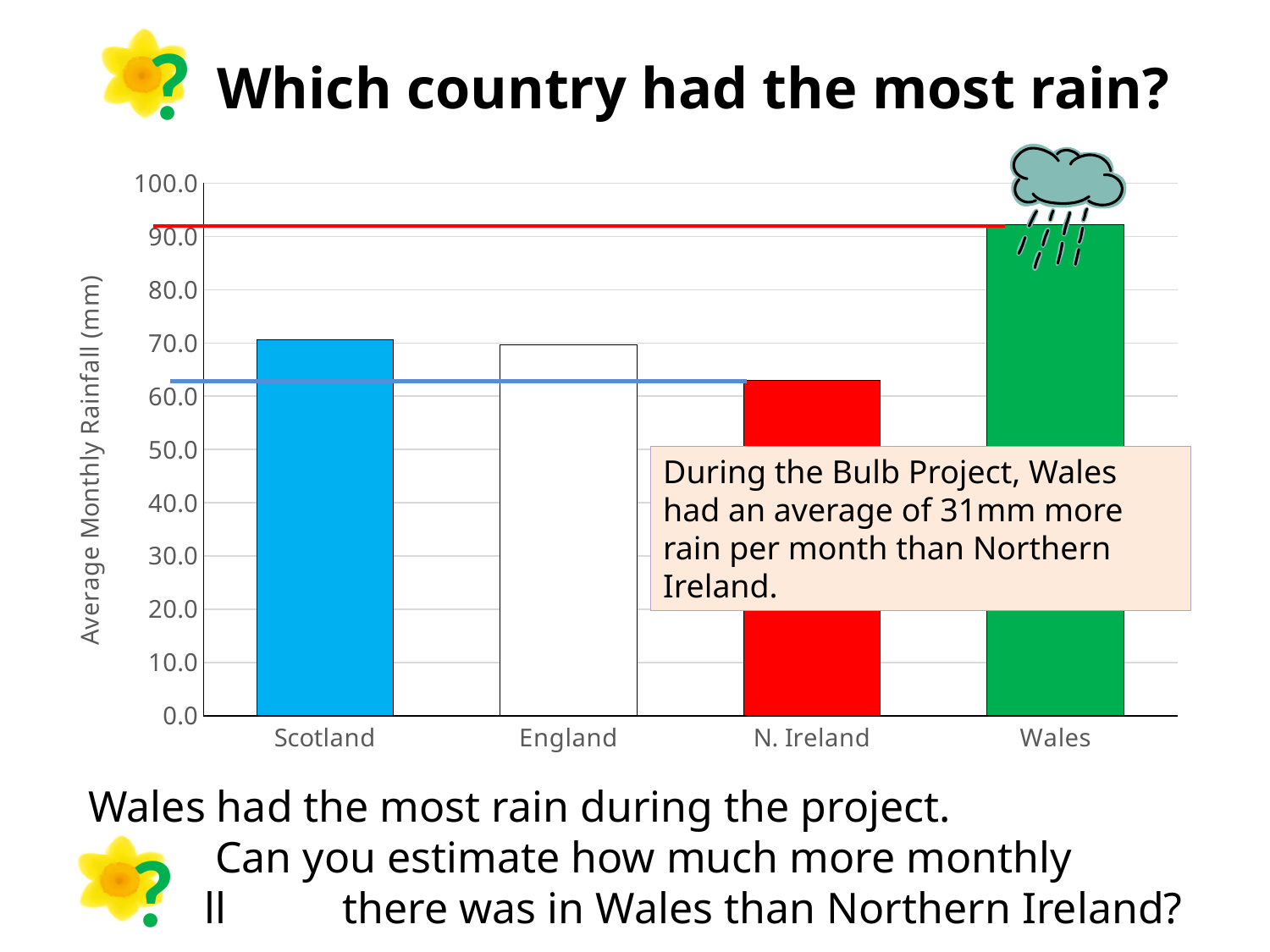
Is the average monthly rainfall for England greater or less than 80? less Which has the higher average monthly rainfall, Scotland or N. Ireland? Scotland Is the average monthly rainfall for N. Ireland greater or less than 70? less Which has the higher average monthly rainfall, Wales or N. Ireland? Wales What colour is the bar for Wales? green Is the average monthly rainfall for Scotland greater or less than 60? greater Which country has the lowest average monthly rainfall in the chart? N. Ireland What kind of chart is shown on the slide? bar chart How many countries are shown on the x axis of the chart? 4 What is the label on the y axis of the chart? Average Monthly Rainfall (mm) Which country has the highest average monthly rainfall in the chart? Wales